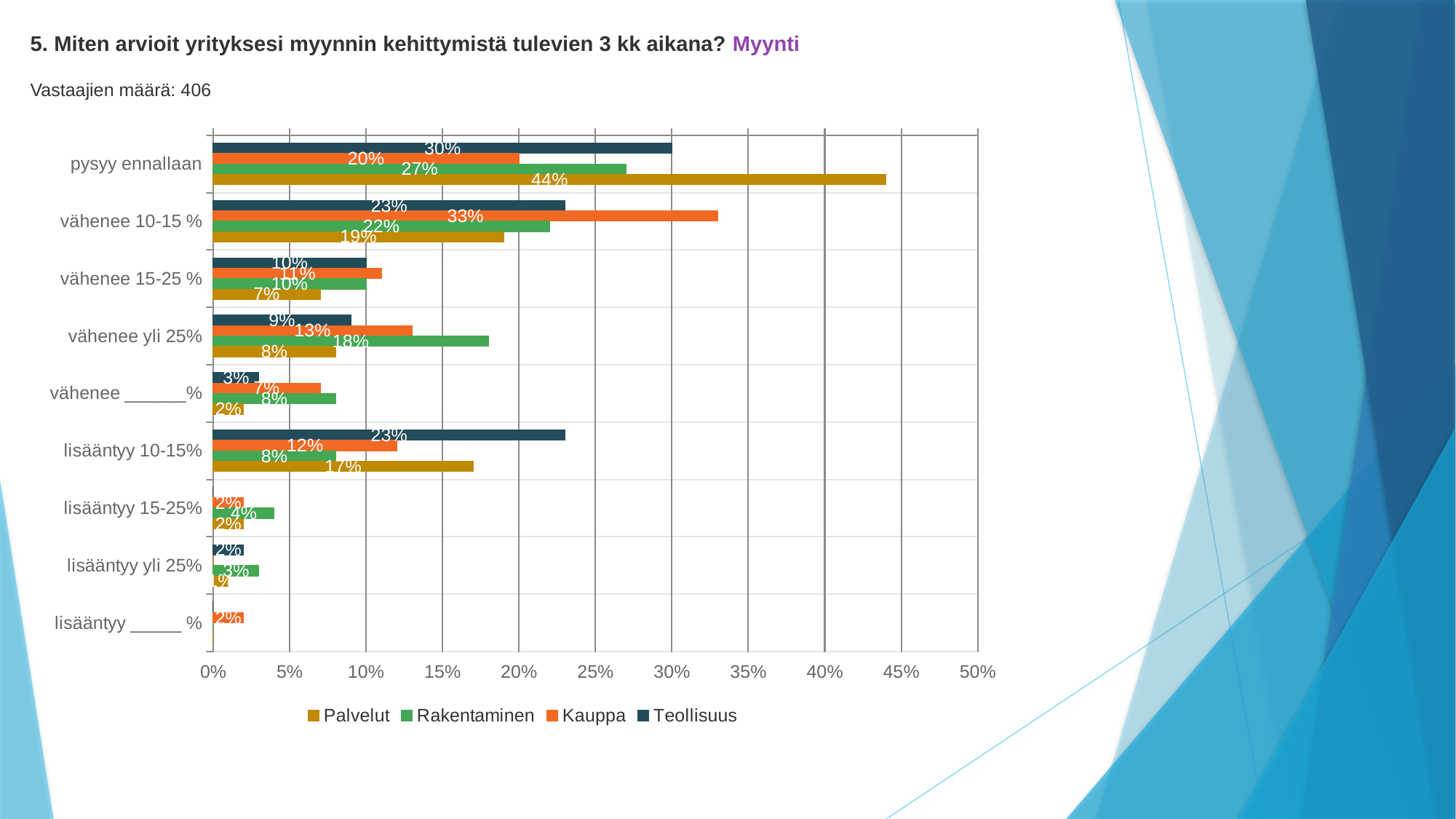
Which series has the lowest value in the 'vähenee ______%' category? Palvelut What is the value for Palvelut in the 'pysyy ennallaan' category? 44% What is the value for Kauppa in the 'vähenee 10-15 %' category? 33% What is the difference between the Palvelut and Kauppa values in the 'pysyy ennallaan' category? 24% What is the value for Rakentaminen in the 'vähenee yli 25%' category? 18% Is the value for Palvelut in the 'pysyy ennallaan' category greater or less than 40%? greater Which series has the highest value in the 'pysyy ennallaan' category? Palvelut How many series does the legend list? 4 How many categories are shown on the vertical axis? 9 What kind of chart is shown on the slide? bar chart In the 'lisääntyy 10-15%' category, which is larger: the value for Teollisuus or the value for Rakentaminen? Teollisuus What is the value for Teollisuus in the 'lisääntyy 10-15%' category? 23%